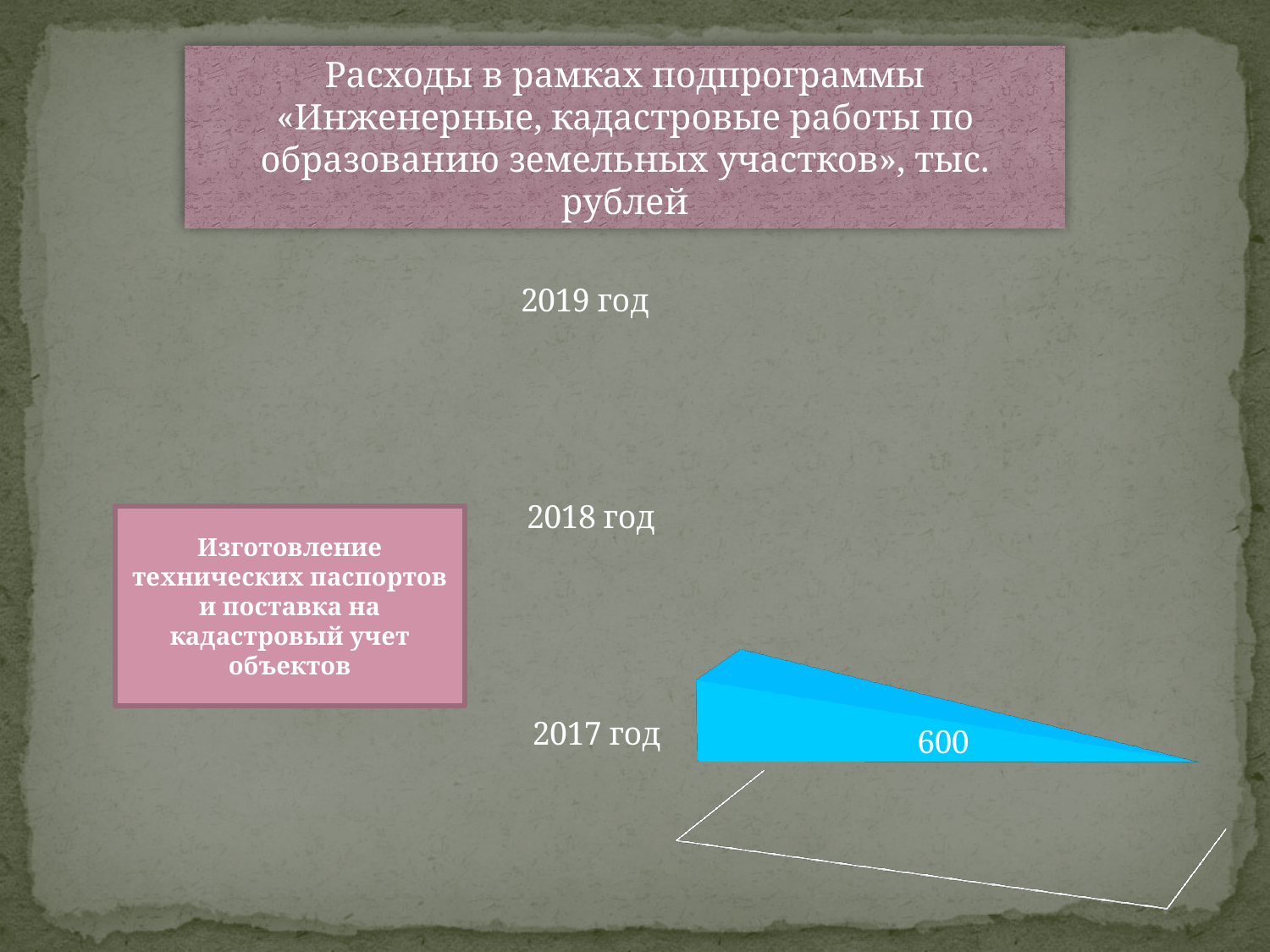
In what units are the expenses on the chart expressed, according to the title? тыс. рублей Which year has the highest value on the chart? 2017 год Which years are listed as categories on the chart? 2017 год, 2018 год, 2019 год Is the value for 2017 год greater or less than 500? greater What is the value for 2017 год? 600 Which year is the only one with a visible bar on the chart? 2017 год How many year categories are shown on the chart? 3 What kind of chart is shown on the slide? bar chart